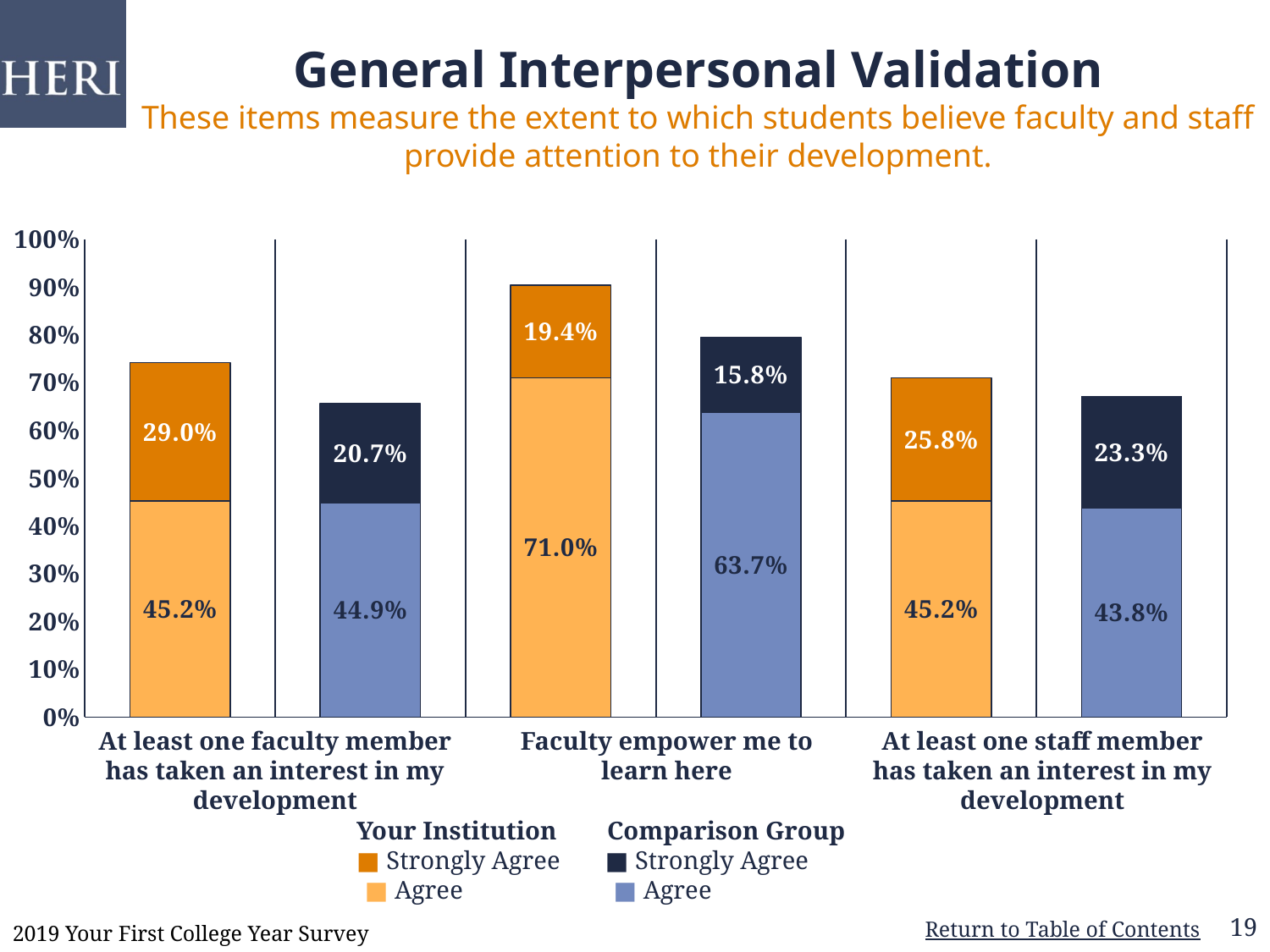
What percentage of Your Institution students Strongly Agree that at least one faculty member has taken an interest in their development? 29.0% Which item has the highest Agree percentage for Your Institution? Faculty empower me to learn here What percentage of the Comparison Group Agree that faculty empower them to learn here? 63.7% How many entries does the chart legend list? 4 What is the difference between the Your Institution and Comparison Group Strongly Agree values for 'At least one faculty member has taken an interest in my development'? 8.3% Which item has the lowest Strongly Agree percentage for the Comparison Group? Faculty empower me to learn here Is the Your Institution Strongly Agree value for 'Faculty empower me to learn here' larger or smaller than the Comparison Group's Strongly Agree value for the same item? larger What is the combined Agree and Strongly Agree total for Your Institution on 'Faculty empower me to learn here'? 90.4% What type of chart is shown on the slide? stacked bar chart How many survey items are shown on the x axis of the chart? 3 What is the combined Agree and Strongly Agree total for the Comparison Group on 'At least one faculty member has taken an interest in my development'? 65.6% What percentage of the Comparison Group Strongly Agree that at least one staff member has taken an interest in their development? 23.3%